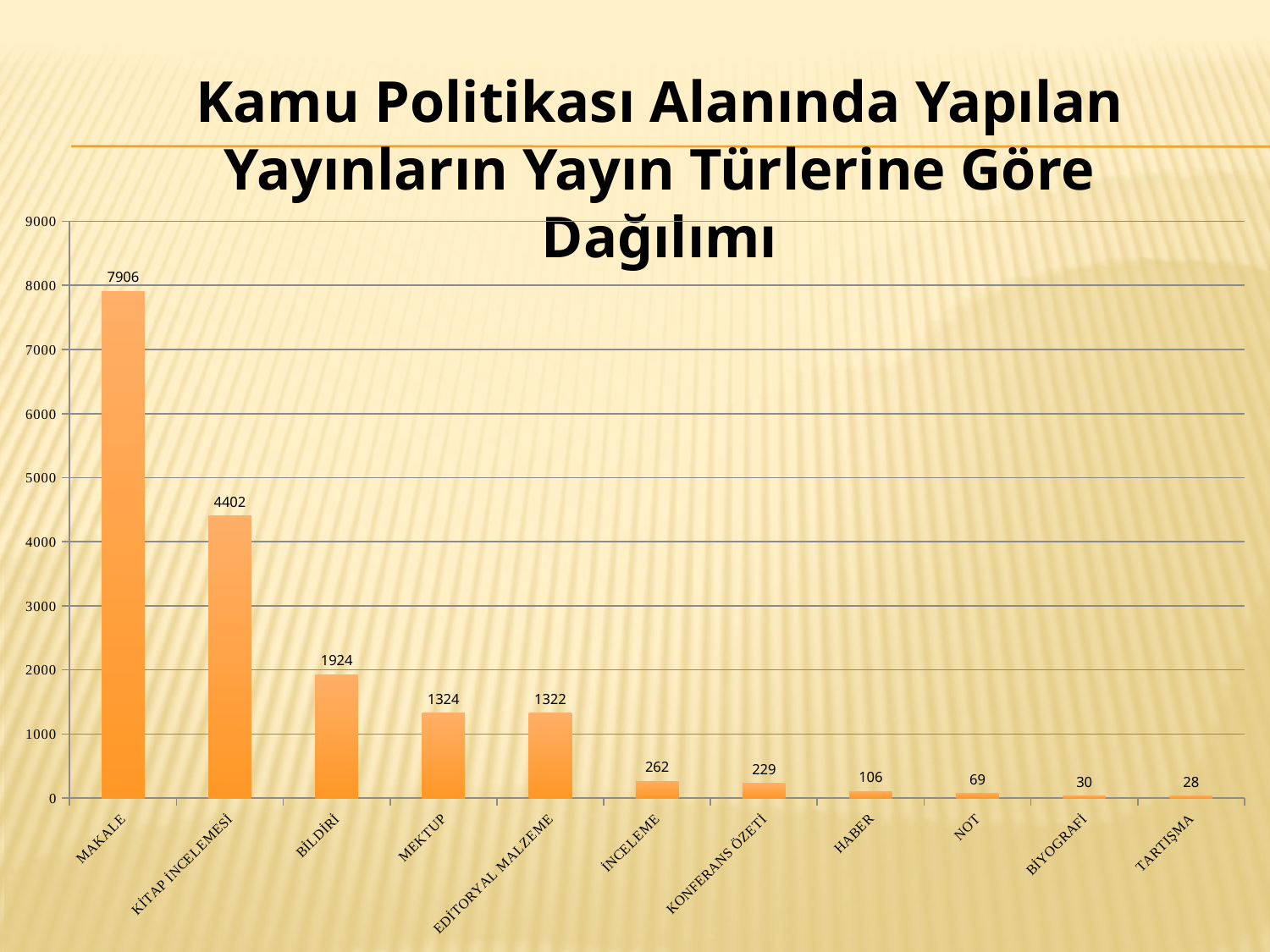
How many categories are shown on the x axis? 11 What is the value for MAKALE? 7906 What is the value for KONFERANS ÖZETİ? 229 What kind of chart is shown on the slide? Bar chart Which is larger, the value for BİLDİRİ or the value for MEKTUP? BİLDİRİ What is the difference between the values for MEKTUP and EDİTORYAL MALZEME? 2 What is the difference between the values for MAKALE and KİTAP İNCELEMESİ? 3504 What is the value for EDİTORYAL MALZEME? 1322 Which category has the lowest value? TARTIŞMA Do the values rise or fall from left to right along the x axis? Fall What is the value for KİTAP İNCELEMESİ? 4402 Which category has the highest value? MAKALE